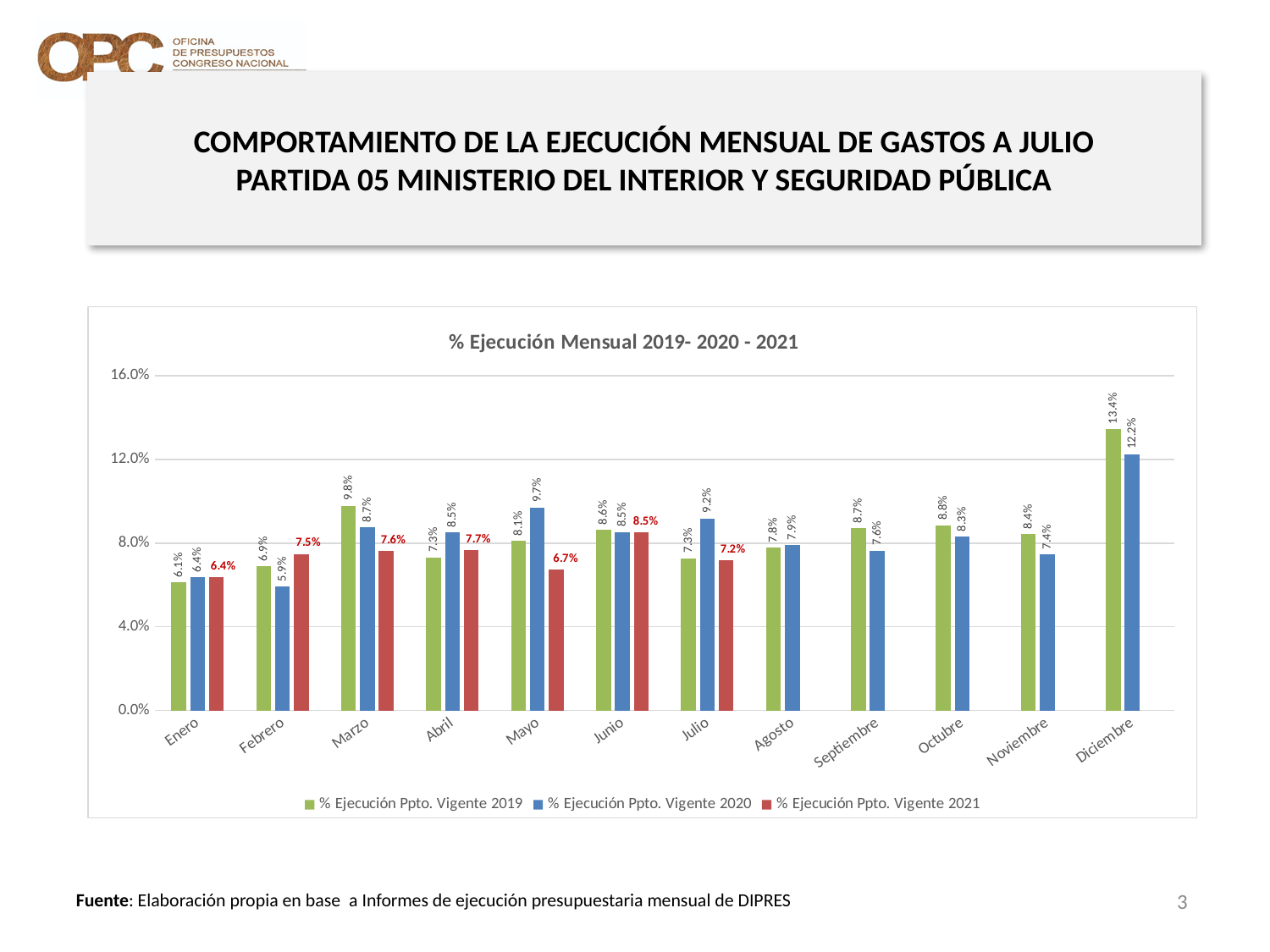
How many months are shown on the x axis? 12 What kind of chart is shown on the slide? Bar chart What is the difference between the 2020 and 2021 values in Mayo? 3.0% Is the value for % Ejecución Ppto. Vigente 2019 in Diciembre greater or less than 12.0%? greater How many series does the legend list? 3 In Febrero, which is larger: the 2019 value or the 2020 value? 2019 What is the value for % Ejecución Ppto. Vigente 2020 in Diciembre? 12.2% What is the title of the chart? % Ejecución Mensual 2019- 2020 - 2021 What is the value for % Ejecución Ppto. Vigente 2021 in Marzo? 7.6% What is the value for % Ejecución Ppto. Vigente 2019 in Mayo? 8.1% Which month has the lowest value for % Ejecución Ppto. Vigente 2021? Enero Which month has the highest value for % Ejecución Ppto. Vigente 2019? Diciembre